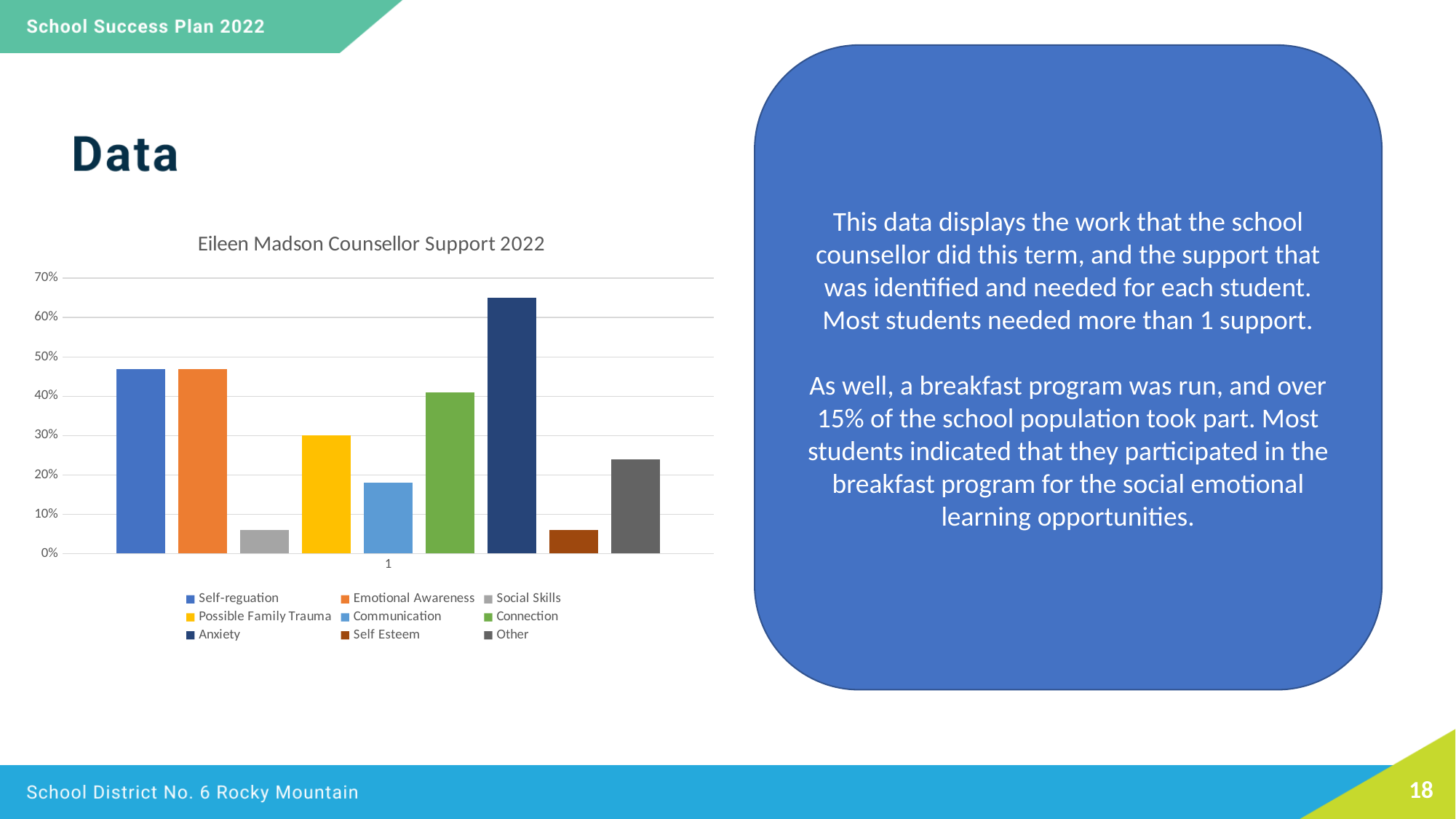
Is the value for Other greater or less than 20%? greater Is the value for Communication greater or less than 20%? less How many series does the chart's legend list? 9 Is the value for Social Skills greater or less than 10%? less What is the title of the chart? Eileen Madson Counsellor Support 2022 What kind of chart is shown on the slide? bar chart Which support type has the highest value in the chart? Anxiety Which colour represents Anxiety in the chart's legend? dark navy blue Which is larger, the value for Connection or the value for Possible Family Trauma? Connection Which is larger, the value for Other or the value for Communication? Other